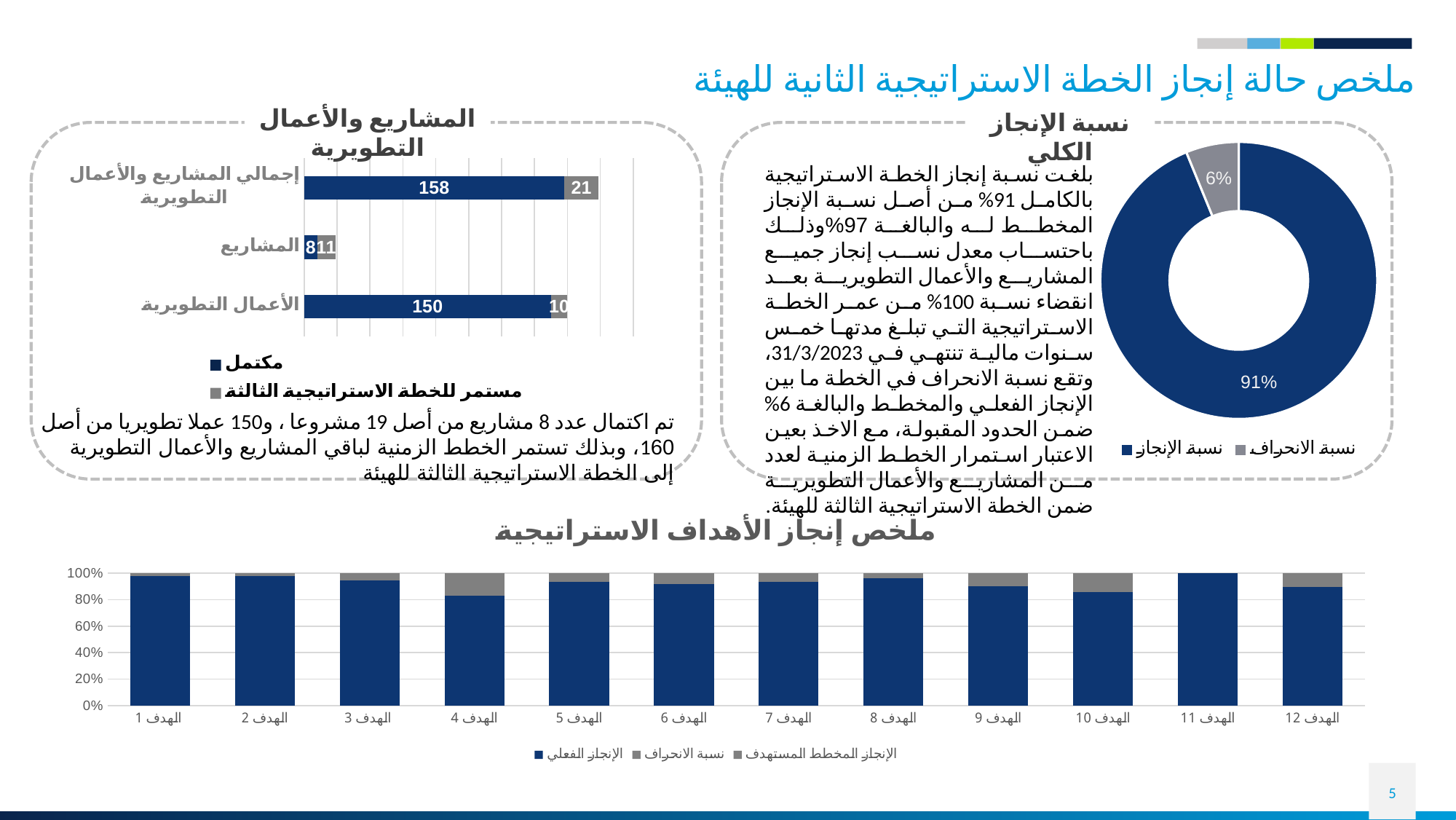
In the 'نسبة الإنجاز الكلي' donut chart, what share is shown for 'نسبة الانحراف'? 6% In the 'المشاريع والأعمال التطويرية' bar chart, what is the 'مستمر للخطة الاستراتيجية الثالثة' value for 'الأعمال التطويرية'? 10 In the 'المشاريع والأعمال التطويرية' bar chart, what is the total of the stacked bar for 'المشاريع'? 19 How many series does the legend of the 'المشاريع والأعمال التطويرية' bar chart list? 2 How many goals (categories) are shown on the x axis of the 'ملخص إنجاز الأهداف الاستراتيجية' chart? 12 In the 'ملخص إنجاز الأهداف الاستراتيجية' chart, which goal has the lowest 'الإنجاز الفعلي' value? الهدف 4 In the 'المشاريع والأعمال التطويرية' bar chart, what is the difference between the 'مكتمل' values for 'الأعمال التطويرية' and 'المشاريع'? 142 In the 'نسبة الإنجاز الكلي' donut chart, what share is shown for 'نسبة الإنجاز'? 91% In the 'المشاريع والأعمال التطويرية' bar chart, what is the 'مكتمل' value for 'إجمالي المشاريع والأعمال التطويرية'? 158 In the 'المشاريع والأعمال التطويرية' bar chart, which category has the highest 'مكتمل' value? إجمالي المشاريع والأعمال التطويرية In the 'المشاريع والأعمال التطويرية' bar chart, what is the 'مكتمل' value for 'المشاريع'? 8 What kind of chart is 'ملخص إنجاز الأهداف الاستراتيجية' at the bottom of the slide? Stacked bar chart